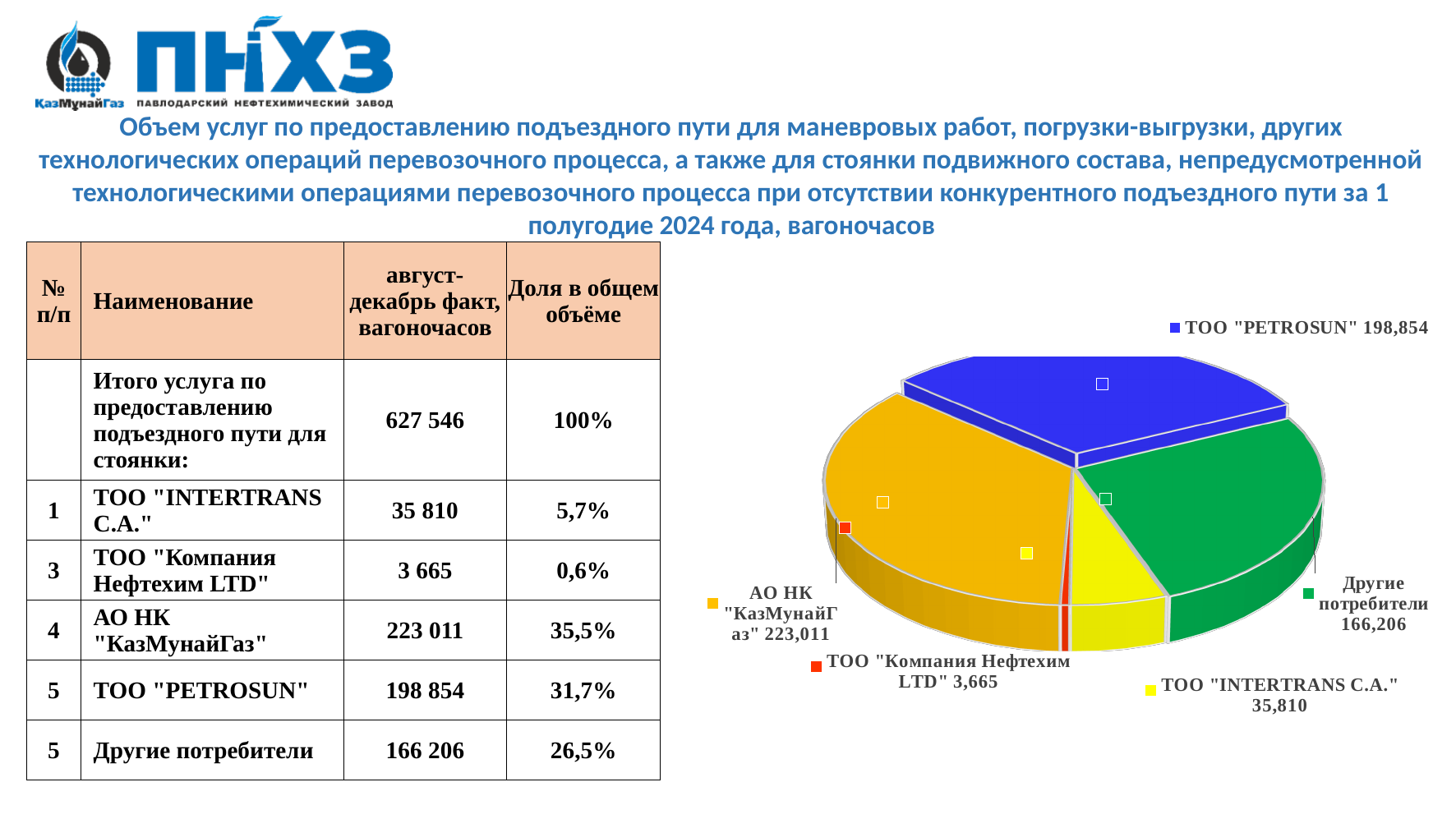
Which slice of the pie chart has the largest value? АО НК "КазМунайГаз" What is the difference between the values for АО НК "КазМунайГаз" and ТОО "PETROSUN" on the pie chart? 24,157 What value is shown for ТОО "PETROSUN" on the pie chart? 198,854 What value is shown for Другие потребители on the pie chart? 166,206 Which slice of the pie chart has the smallest value? ТОО "Компания Нефтехим LTD" What share of the total does ТОО "INTERTRANS C.A." represent, according to the table? 5,7% Which is larger on the pie chart: ТОО "PETROSUN" or Другие потребители? ТОО "PETROSUN" How many slices does the pie chart have? 5 What kind of chart is shown on the slide? Pie chart What colour is the slice for ТОО "INTERTRANS C.A." on the pie chart? Yellow What value is shown for АО НК "КазМунайГаз" on the pie chart? 223,011 What value is shown for ТОО "Компания Нефтехим LTD" on the pie chart? 3,665